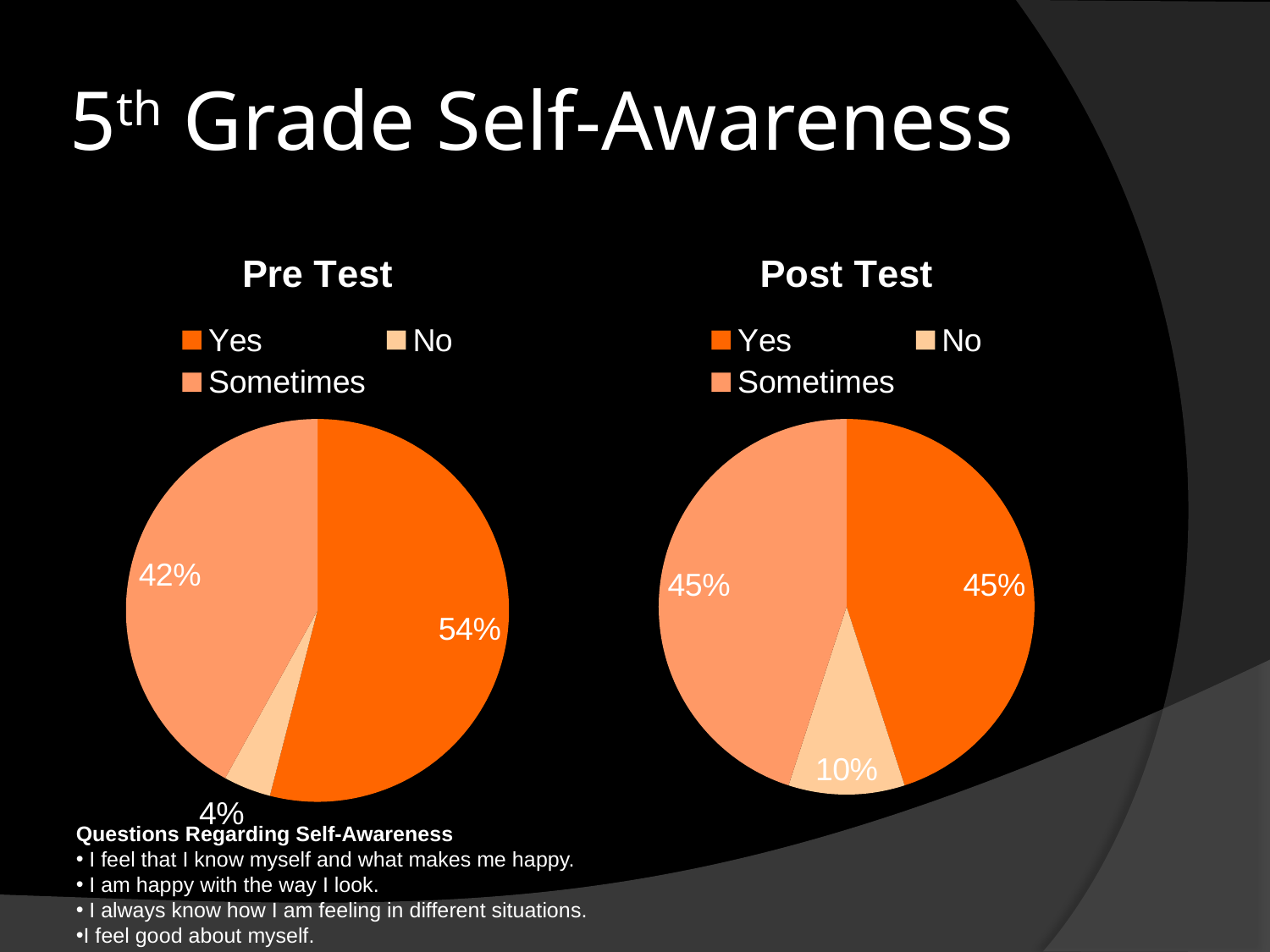
In the Post Test chart, what percentage of responses were "No"? 10% In the Pre Test chart, which response category has the largest share? Yes What type of chart is the Post Test chart? Pie chart In the Post Test chart, which response category has the smallest share? No In the Post Test chart, what percentage of responses were "Yes"? 45% What is the difference between the "No" share in the Post Test chart and the "No" share in the Pre Test chart? 6% In the Pre Test chart, what percentage of responses were "Sometimes"? 42% In the Pre Test chart, what percentage of responses were "No"? 4% How many categories does the legend of the Pre Test chart list? 3 In the Pre Test chart, which is larger: the "Sometimes" share or the "No" share? Sometimes In the Pre Test chart, what is the difference between the "Yes" share and the "Sometimes" share? 12% In the Pre Test chart, what percentage of responses were "Yes"? 54%